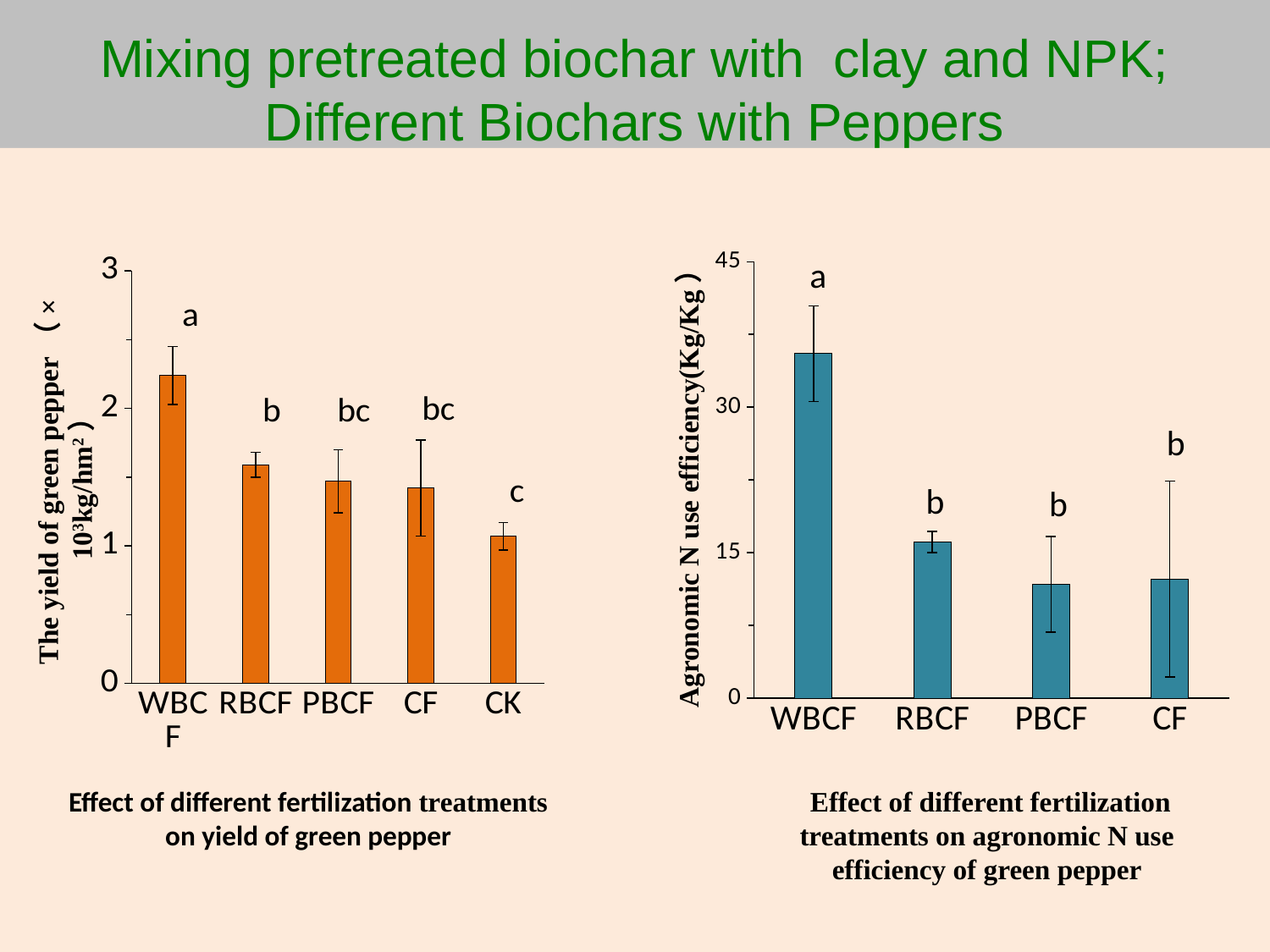
In the right chart (agronomic N use efficiency), is the value for PBCF greater or less than 15? less In the left chart (yield of green pepper), is the value for CK greater or less than 2? less In the left chart (yield of green pepper), how many treatment categories are shown on the x axis? 5 In the right chart (agronomic N use efficiency), how many treatment categories are shown on the x axis? 4 In the left chart (yield of green pepper), is the value for WBCF greater or less than 2? greater In the left chart (yield of green pepper), which is larger, the value for RBCF or the value for CK? RBCF In the right chart (agronomic N use efficiency), what significance letter is printed above the WBCF bar? a In the left chart (yield of green pepper), what kind of chart is shown? bar chart In the left chart (yield of green pepper), which treatment has the highest yield? WBCF In the right chart (agronomic N use efficiency), which treatment has the highest value? WBCF In the left chart (yield of green pepper), which treatment has the lowest yield? CK